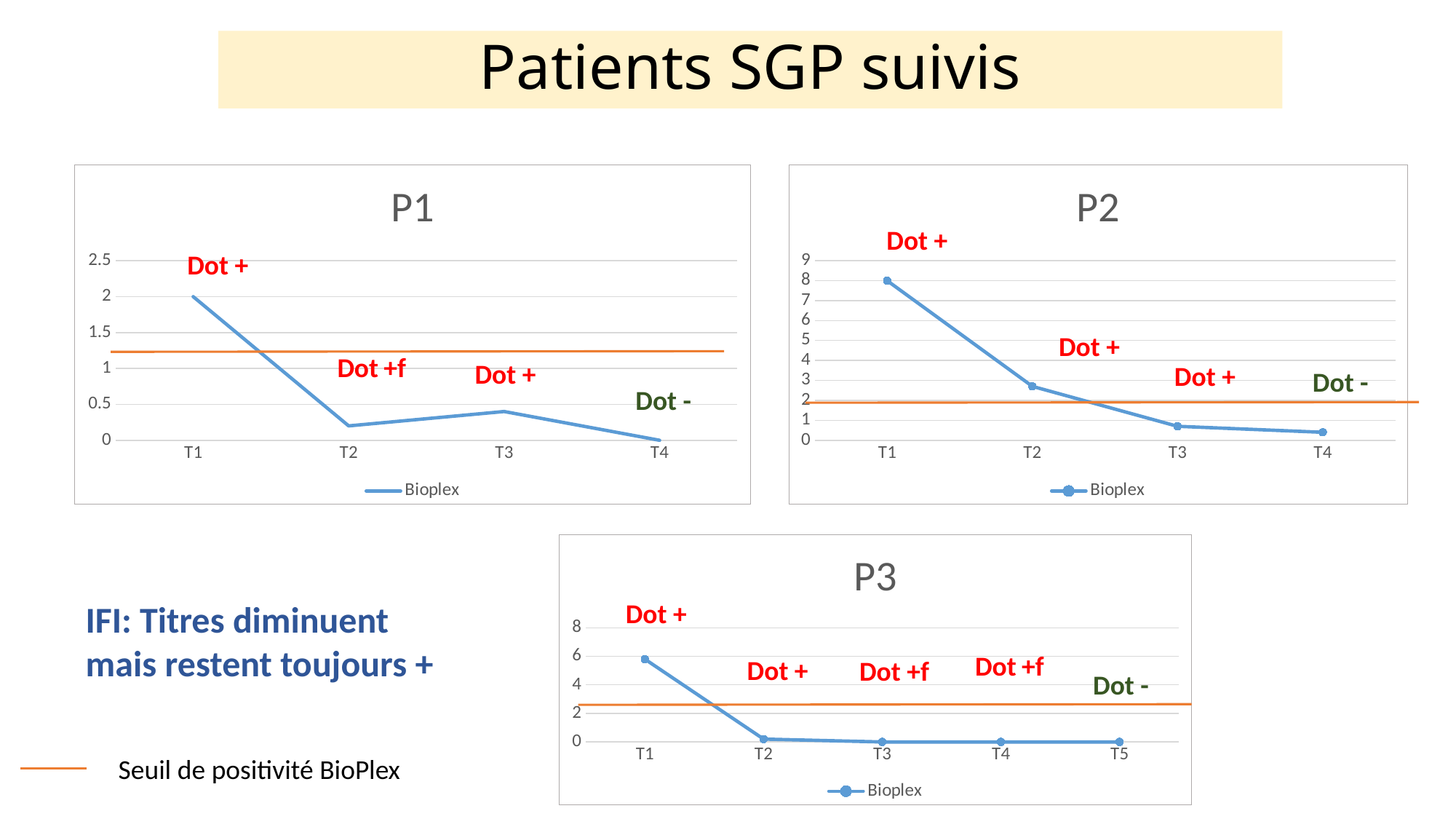
In the P3 chart, how many time points are plotted on the x axis? 5 In the P2 chart, is the Bioplex value at T2 greater or less than 2? greater What kind of chart is the P1 chart? line chart In the P1 chart, is the Bioplex value at T2 greater or less than 0.5? less How many series does the legend of the P2 chart list? 1 In the P2 chart, at which time point is the Bioplex value highest? T1 In the P2 chart, does the Bioplex value rise or fall from T1 to T4? fall What is the name of the series shown in the legend of the P3 chart? Bioplex In the P1 chart, how many time points are plotted on the x axis? 4 In the P3 chart, is the Bioplex value at T1 greater or less than 4? greater In the P2 chart, what is the Bioplex value at T1? 8 In the P1 chart, what is the Bioplex value at T1? 2